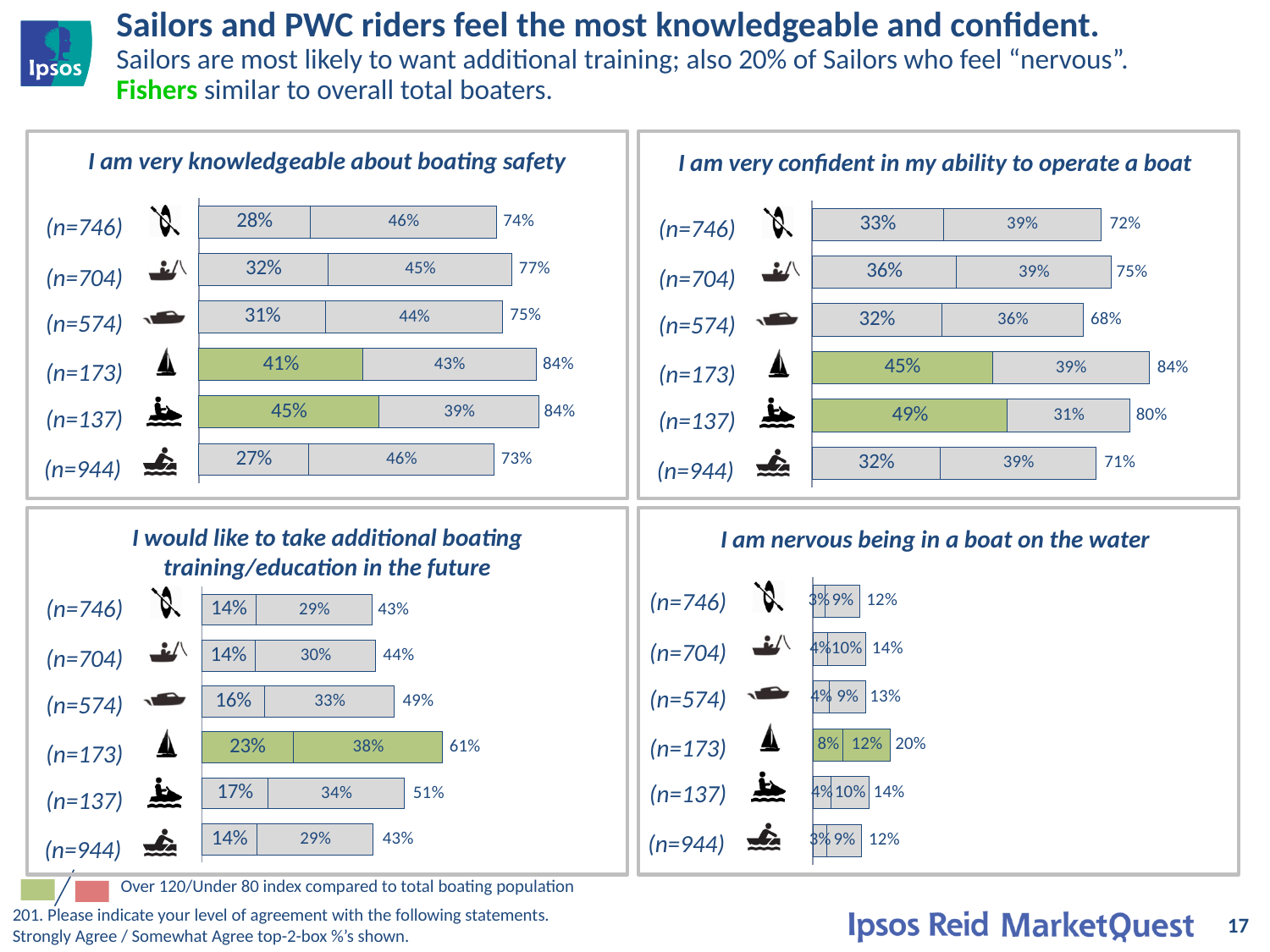
In the chart 'I would like to take additional boating training/education in the future', what is the sum of the two segments for the (n=137) group? 51% In the chart 'I am very knowledgeable about boating safety', what is the total (top-2-box) percentage for the (n=173) group? 84% In the chart 'I am very confident in my ability to operate a boat', which group has the lowest total percentage? (n=574) In the chart 'I am nervous being in a boat on the water', what is the difference between the total percentage for (n=173) and the total percentage for (n=746)? 8% In the chart 'I am very knowledgeable about boating safety', which is larger: the total percentage for (n=704) or for (n=574)? (n=704) In the chart 'I would like to take additional boating training/education in the future', which group has the highest total percentage? (n=173) In the chart 'I am very confident in my ability to operate a boat', what is the difference between the total percentages for (n=173) and (n=944)? 13% In the chart 'I am nervous being in a boat on the water', what is the somewhat agree percentage for the (n=173) group? 12% In the chart 'I am very confident in my ability to operate a boat', what is the strongly agree percentage for the (n=137) group? 49% According to the legend at the bottom of the slide, what does a green bar segment indicate? Over 120 index compared to total boating population How many groups (bars) are shown in the chart 'I would like to take additional boating training/education in the future'? 6 What type of chart is 'I am nervous being in a boat on the water'? Stacked bar chart